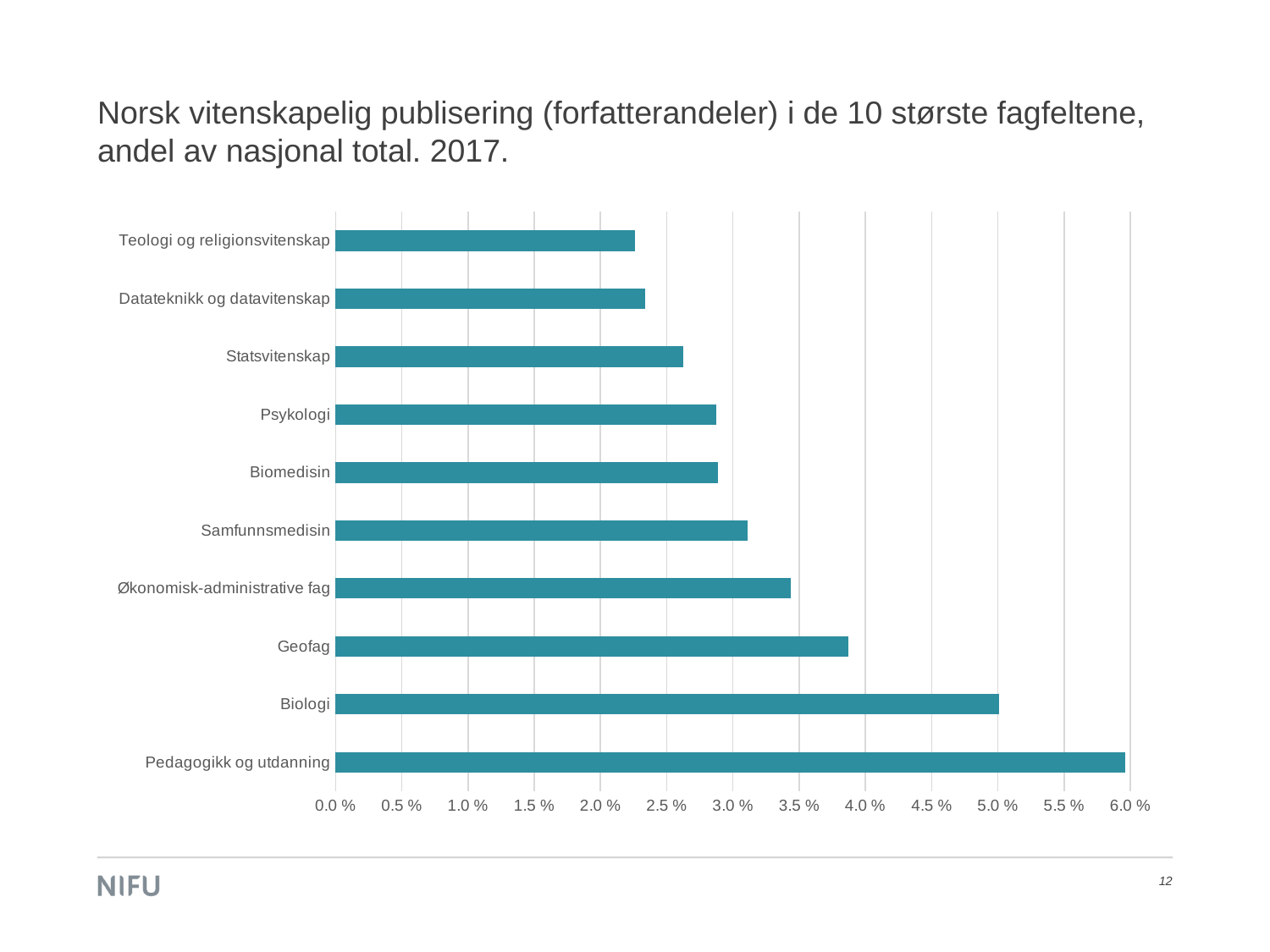
Is the value for Pedagogikk og utdanning greater or less than 5.5 %? greater Is the value for Samfunnsmedisin greater or less than 3.0 %? greater How many categories (fagfelt) are shown in the chart? 10 Is the value for Geofag greater or less than 4.0 %? less What kind of chart is shown on the slide? bar chart Which is larger, the value for Biologi or the value for Geofag? Biologi Which category has the highest value? Pedagogikk og utdanning Which is larger, the value for Statsvitenskap or the value for Samfunnsmedisin? Samfunnsmedisin What year does the chart title say the data is for? 2017